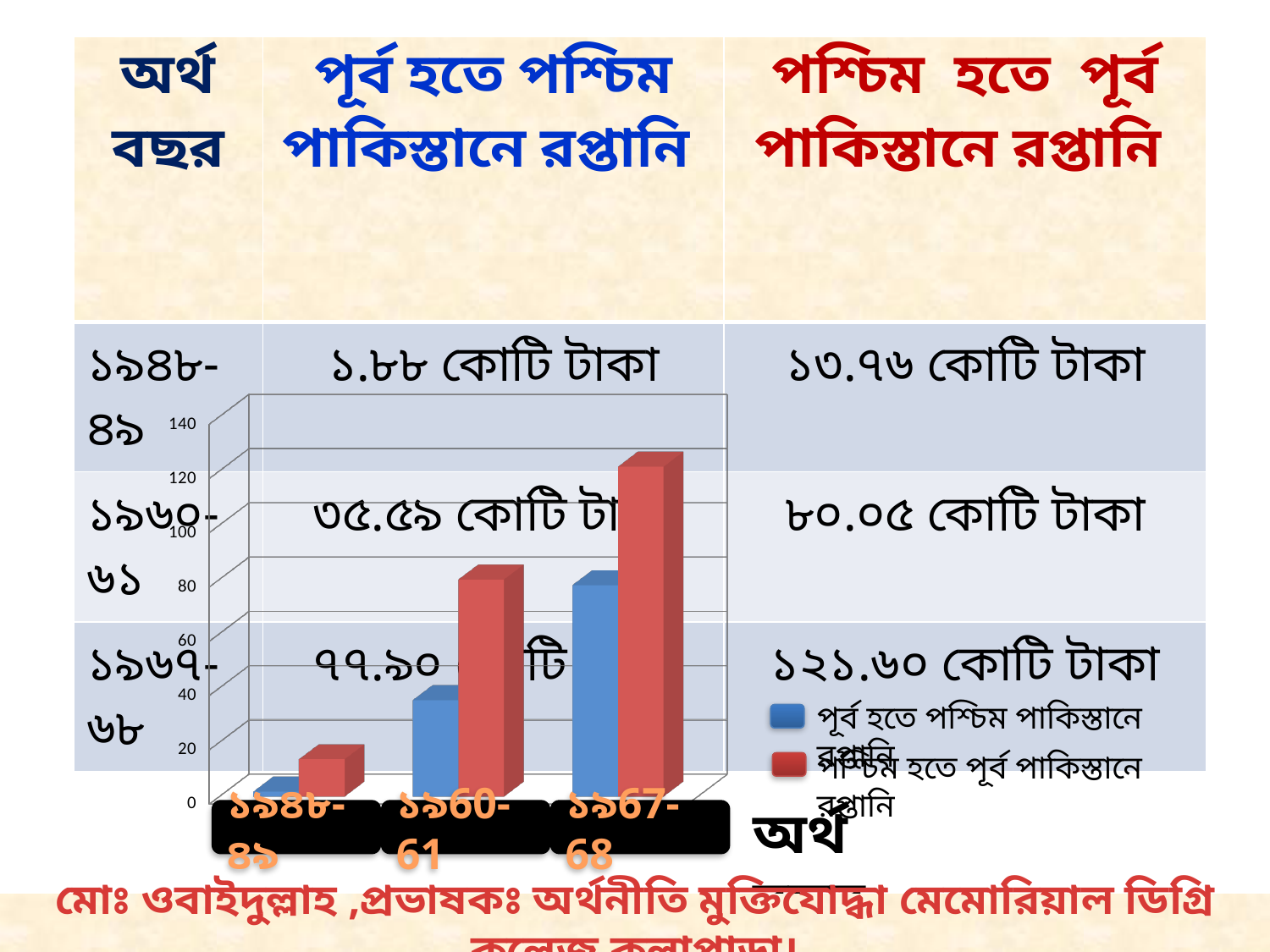
In the chart, is the value for পূর্ব হতে পশ্চিম পাকিস্তানে রপ্তানি in ১৯৪৮-৪৯ greater or less than 20? less In the chart, is the value for পূর্ব হতে পশ্চিম পাকিস্তানে রপ্তানি in ১৯60-61 greater or less than 60? less In the chart, is the value for পশ্চিম হতে পূর্ব পাকিস্তানে রপ্তানি in ১৯67-68 greater or less than 100? greater Which fiscal year has the highest value for পশ্চিম হতে পূর্ব পাকিস্তানে রপ্তানি in the chart? ১৯67-68 What kind of chart is shown on the slide? bar chart Which series is shown in red in the chart? পশ্চিম হতে পূর্ব পাকিস্তানে রপ্তানি Do the values for পশ্চিম হতে পূর্ব পাকিস্তানে রপ্তানি rise or fall from ১৯৪৮-৪৯ to ১৯67-68 in the chart? rise In ১৯60-61, which series has the larger value in the chart: পূর্ব হতে পশ্চিম পাকিস্তানে রপ্তানি or পশ্চিম হতে পূর্ব পাকিস্তানে রপ্তানি? পশ্চিম হতে পূর্ব পাকিস্তানে রপ্তানি Which series is shown in blue in the chart? পূর্ব হতে পশ্চিম পাকিস্তানে রপ্তানি How many fiscal-year categories are shown on the chart's x axis? 3 Which fiscal year has the lowest value for পূর্ব হতে পশ্চিম পাকিস্তানে রপ্তানি in the chart? ১৯৪৮-৪৯ How many series does the chart legend list? 2